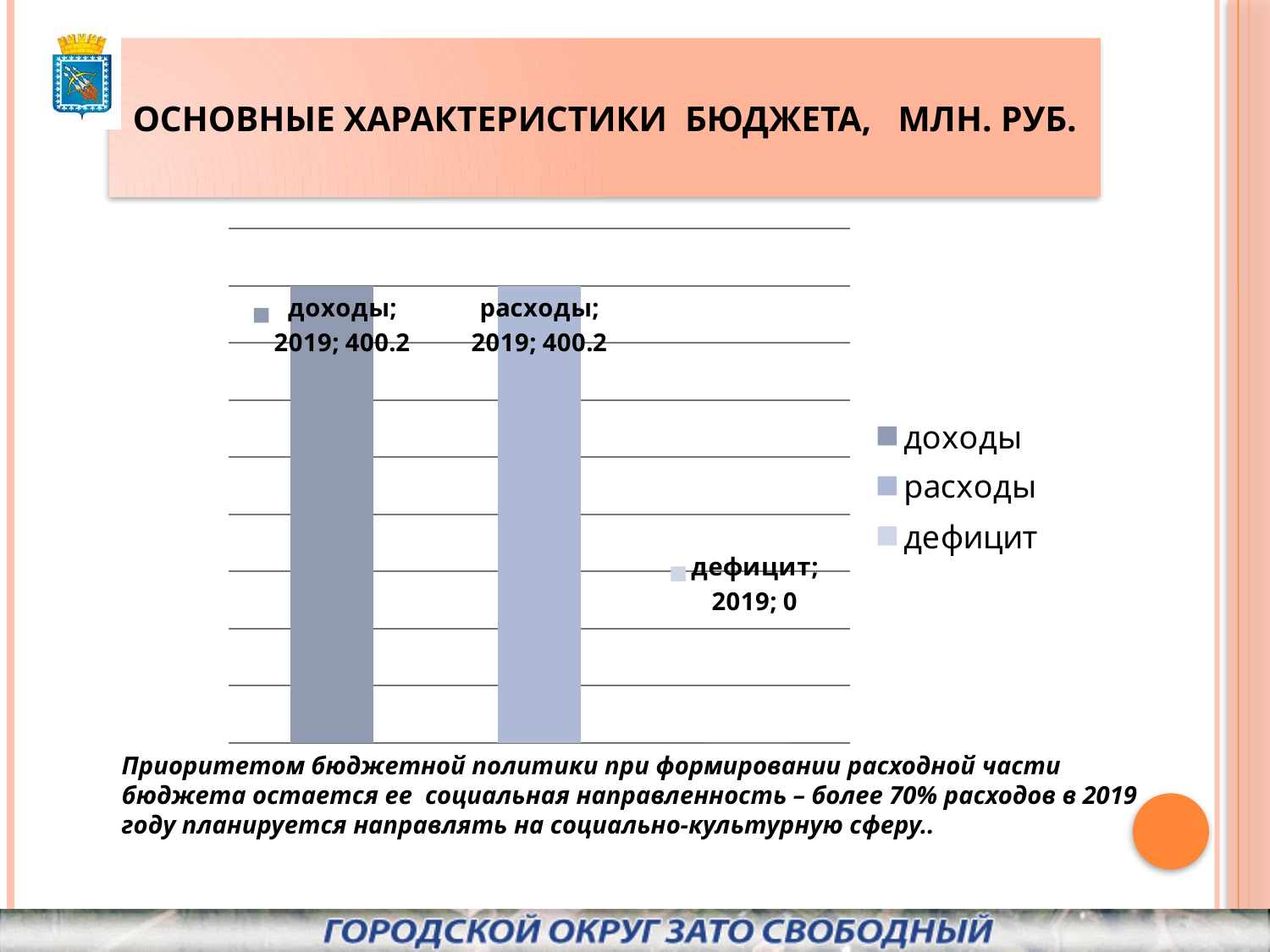
Which is larger, the value for расходы or the value for дефицит? расходы How many series does the legend list? 3 What is the title of the slide above the chart? ОСНОВНЫЕ ХАРАКТЕРИСТИКИ БЮДЖЕТА, МЛН. РУБ. What is the difference between доходы and дефицит in 2019? 400.2 What kind of chart is shown on the slide? bar chart What is the value for доходы in 2019? 400.2 What is the difference between доходы and расходы in 2019? 0 Which series has the lowest value on the chart? дефицит Which legend entry is listed first? доходы What year do the data labels on the chart refer to? 2019 What is the value for дефицит in 2019? 0 What is the value for расходы in 2019? 400.2